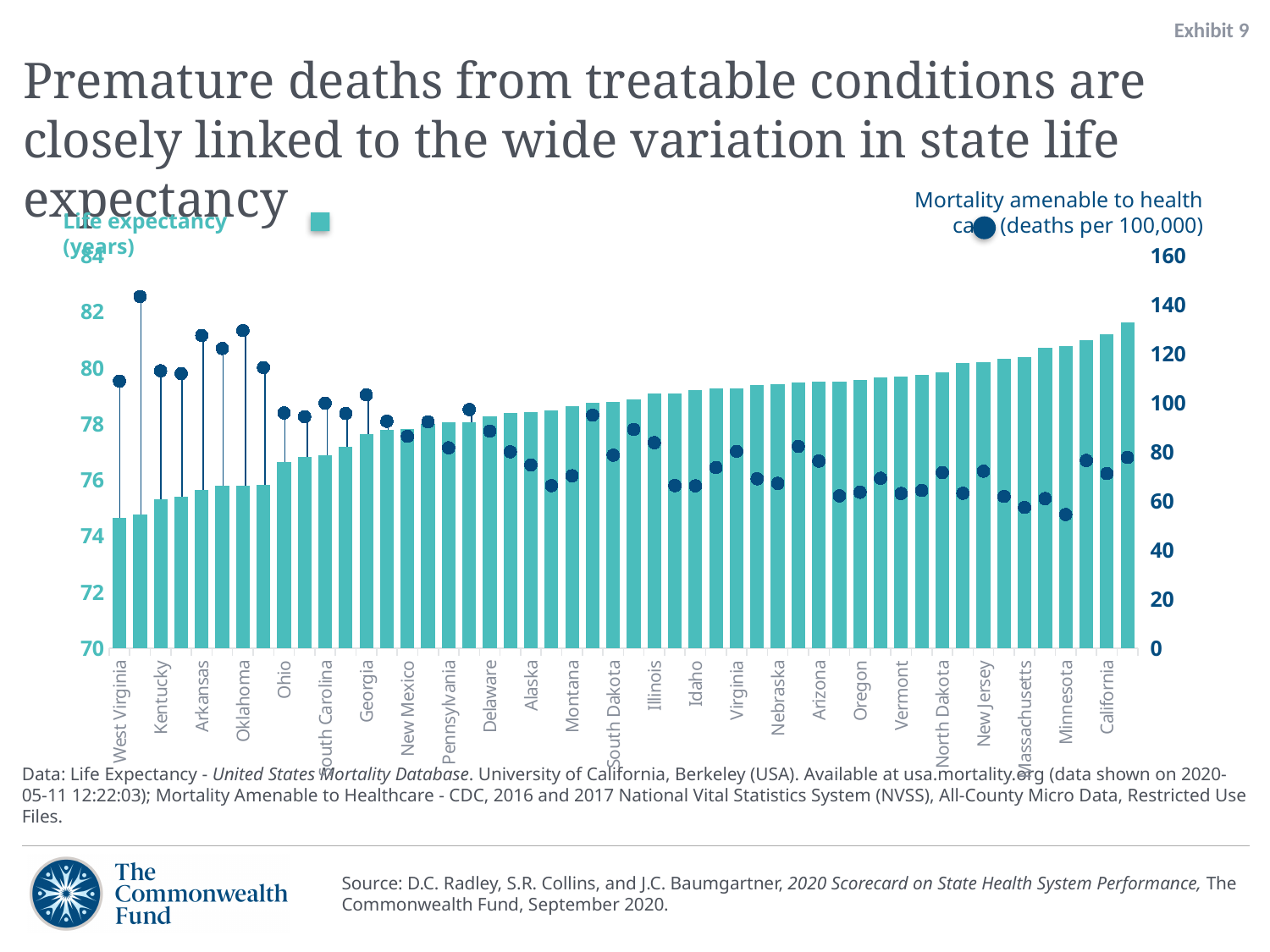
Is the life expectancy bar for West Virginia greater or less than 76 years? less What is the maximum value shown on the right-hand axis for mortality amenable to health care? 160 Is the mortality amenable to health care value for Minnesota greater or less than 60 deaths per 100,000? less Is the life expectancy bar for Ohio greater or less than 78 years? less What kind of chart is shown on the slide? combination chart (bars with dot markers) Do the life expectancy bars rise or fall moving from left to right across the states? rise Which state has the higher mortality amenable to health care value, Oklahoma or Minnesota? Oklahoma Which state has the higher life expectancy bar, West Virginia or California? California How many series does the legend list? 2